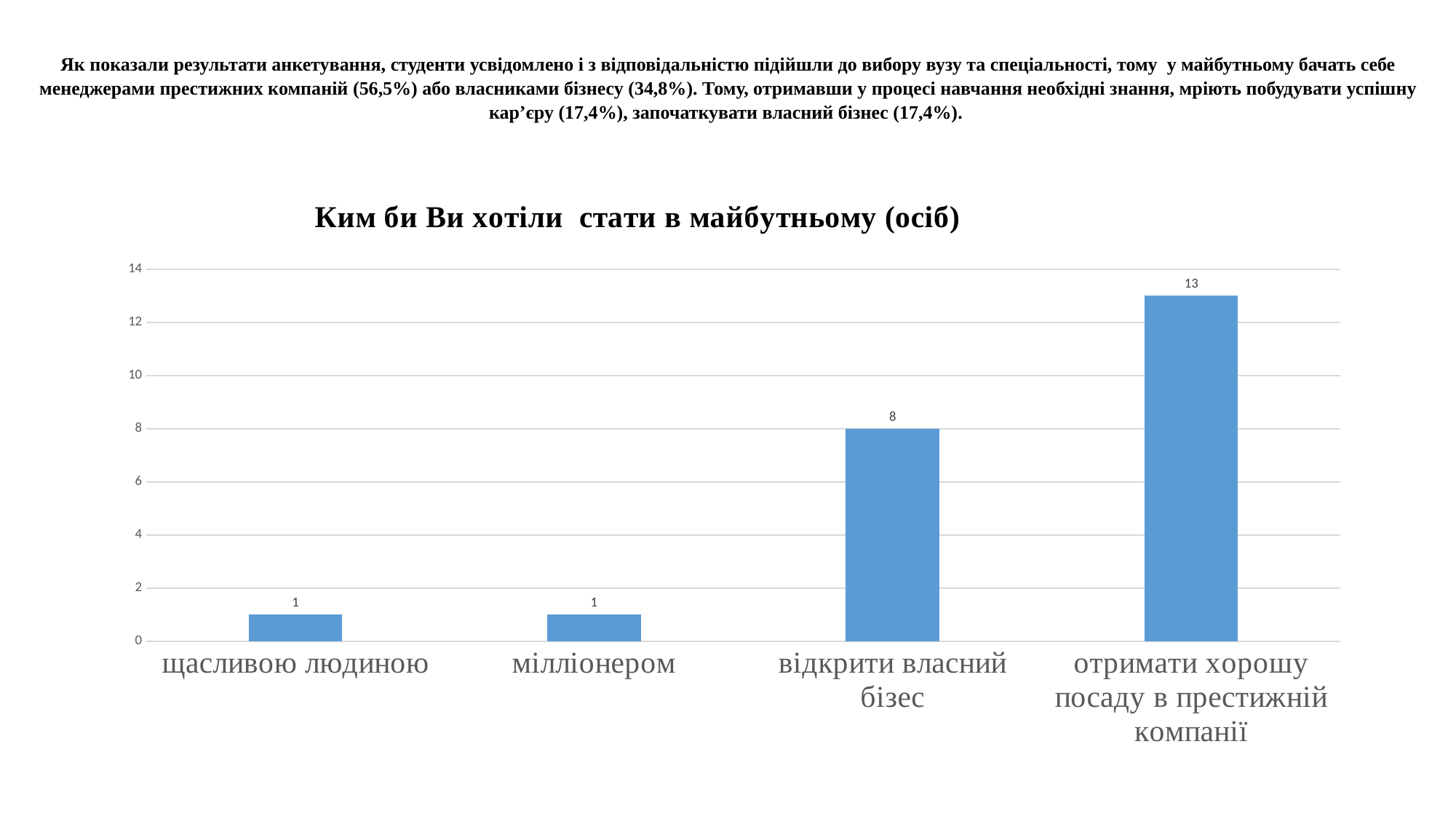
Is the value for "отримати хорошу посаду в престижній компанії" greater or less than 10? greater What is the value for "щасливою людиною"? 1 What is the value for "отримати хорошу посаду в престижній компанії"? 13 What is the title of the chart? Ким би Ви хотіли стати в майбутньому (осіб) Which is larger: the value for "відкрити власний бізес" or the value for "мілліонером"? відкрити власний бізес Which category has the highest value? отримати хорошу посаду в престижній компанії What kind of chart is shown on the slide? bar chart What is the total of the values for "щасливою людиною" and "мілліонером"? 2 What is the value for "мілліонером"? 1 What is the value for "відкрити власний бізес"? 8 How many categories are shown on the x axis? 4 What is the difference between the values for "отримати хорошу посаду в престижній компанії" and "відкрити власний бізес"? 5